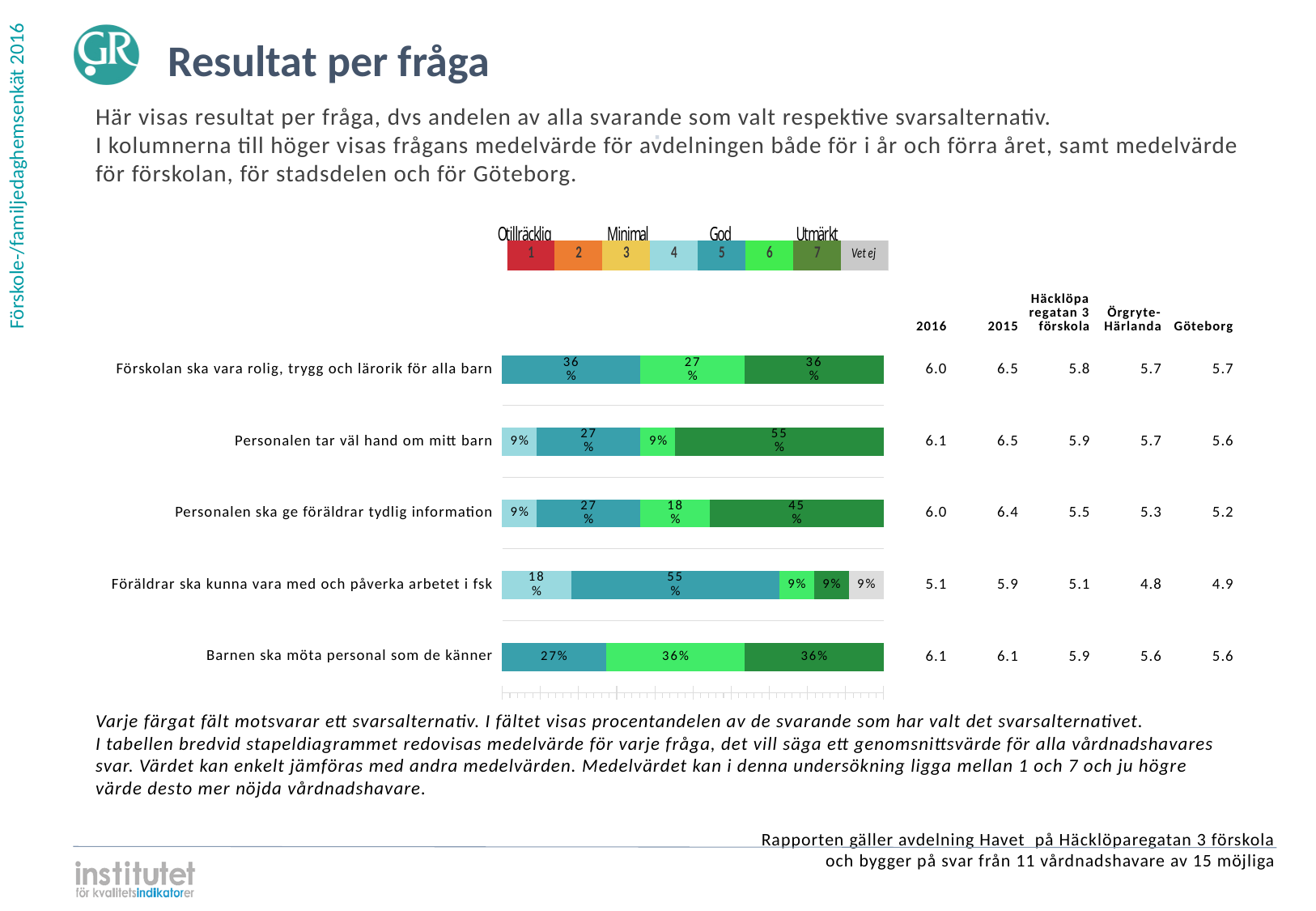
What kind of chart is shown on the slide? Stacked bar chart What percentage of respondents chose the dark green (7, Utmärkt) option for 'Personalen tar väl hand om mitt barn'? 55% What is the 2016 mean value shown for 'Föräldrar ska kunna vara med och påverka arbetet i fsk'? 5.1 Which is larger: the teal (5) share for 'Förskolan ska vara rolig, trygg och lärorik för alla barn' or the teal (5) share for 'Barnen ska möta personal som de känner'? Förskolan ska vara rolig, trygg och lärorik för alla barn How many answer categories does the legend above the chart list? 8 How many questions (categories) are plotted in the bar chart? 5 What percentage chose the teal (5) option for 'Föräldrar ska kunna vara med och påverka arbetet i fsk'? 55% Which question has the largest share of respondents choosing the dark green (7) option? Personalen tar väl hand om mitt barn What percentage chose the light green (6) option for 'Barnen ska möta personal som de känner'? 36% Which question has the smallest share of respondents choosing the dark green (7) option? Föräldrar ska kunna vara med och påverka arbetet i fsk What is the difference between the dark green (7) share for 'Personalen ska ge föräldrar tydlig information' and for 'Förskolan ska vara rolig, trygg och lärorik för alla barn'? 9 percentage points What is the total of the labelled segments in the bar for 'Föräldrar ska kunna vara med och påverka arbetet i fsk'? 100%